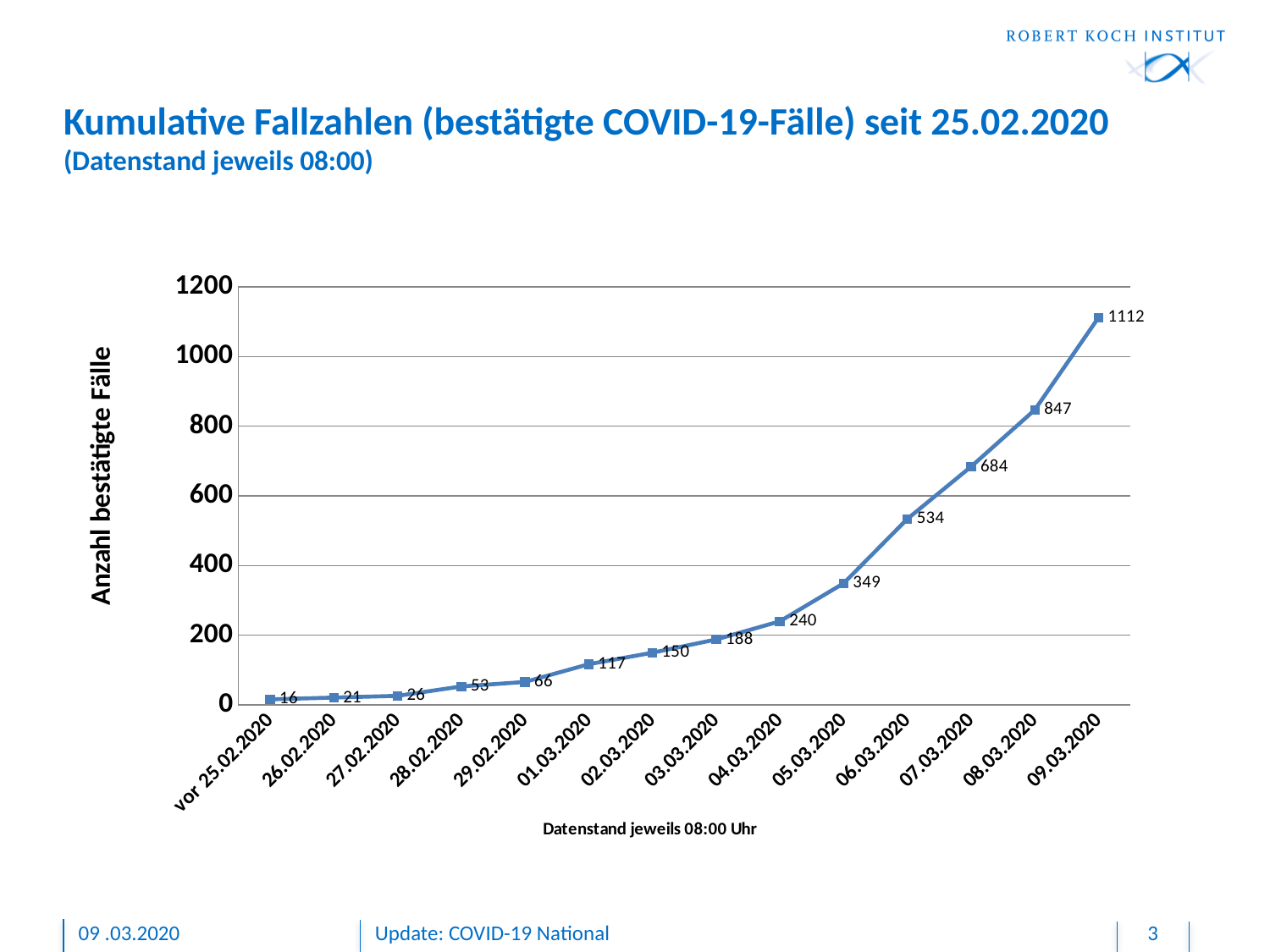
What is the difference between the values for 09.03.2020 and 08.03.2020? 265 Is the value for 08.03.2020 greater or less than 800? greater What is the value for 28.02.2020? 53 What is the value for 05.03.2020? 349 Which date has the highest value? 09.03.2020 Which category has the lowest value? vor 25.02.2020 How many data points are plotted on the chart? 14 What kind of chart is shown on the slide? line chart Which is larger, the value for 04.03.2020 or the value for 03.03.2020? 04.03.2020 What is the difference between the values for 07.03.2020 and 06.03.2020? 150 Do the values rise or fall along the x axis? rise What is the value for 09.03.2020? 1112